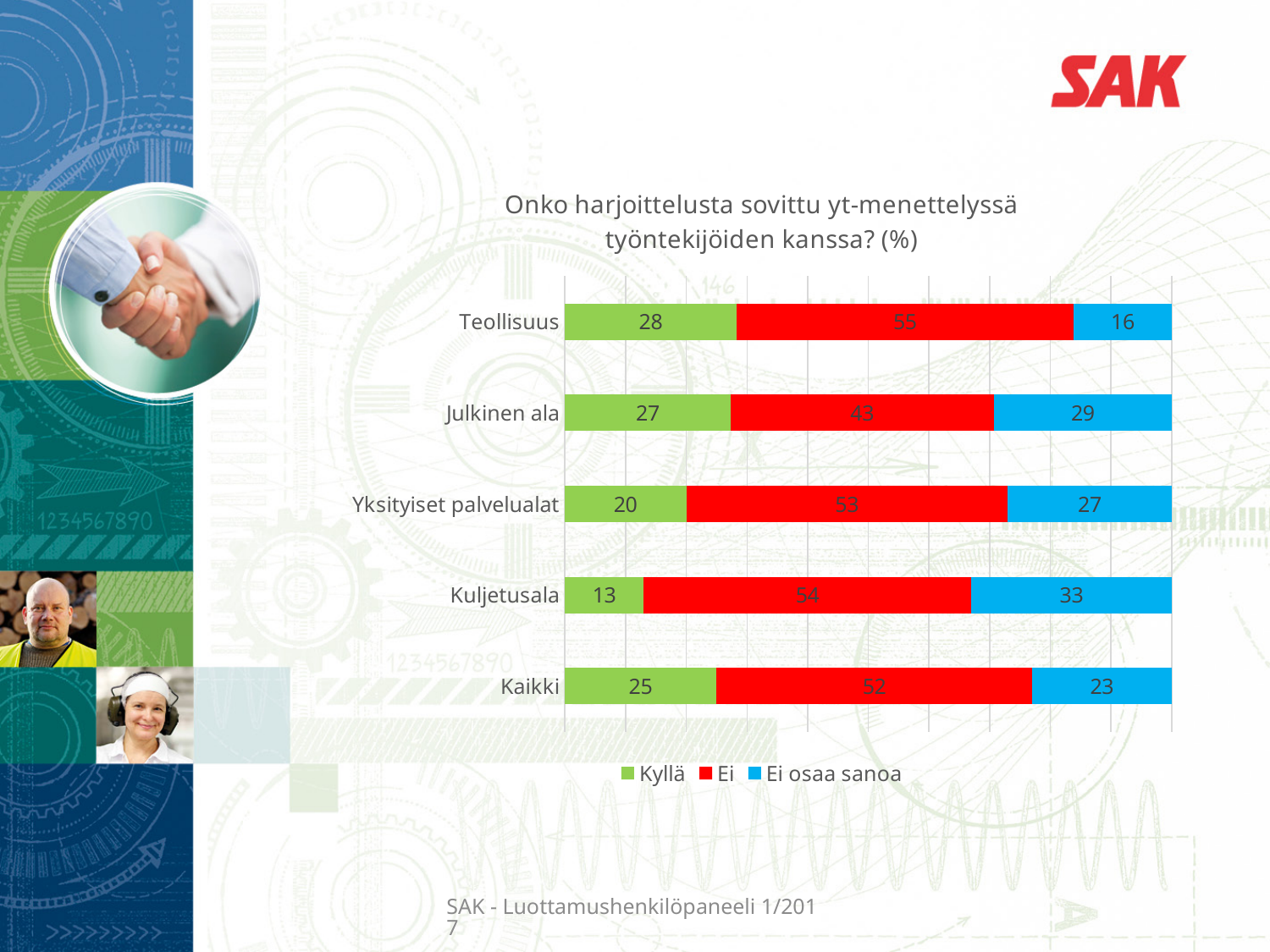
Which category has the highest "Kyllä" value? Teollisuus What is the "Ei" value for Julkinen ala? 43 How many series does the legend list? 3 Which category has the lowest "Kyllä" value? Kuljetusala Which is larger: the "Ei osaa sanoa" value for Julkinen ala or for Teollisuus? Julkinen ala How many categories are shown on the chart? 5 What is the difference between the "Ei" values for Teollisuus and Julkinen ala? 12 What is the "Ei osaa sanoa" value for Kuljetusala? 33 What is the "Kyllä" value for Teollisuus? 28 What is the "Kyllä" value for Kaikki? 25 What kind of chart is shown on the slide? Stacked bar chart What is the total of the stacked bar for Yksityiset palvelualat? 100